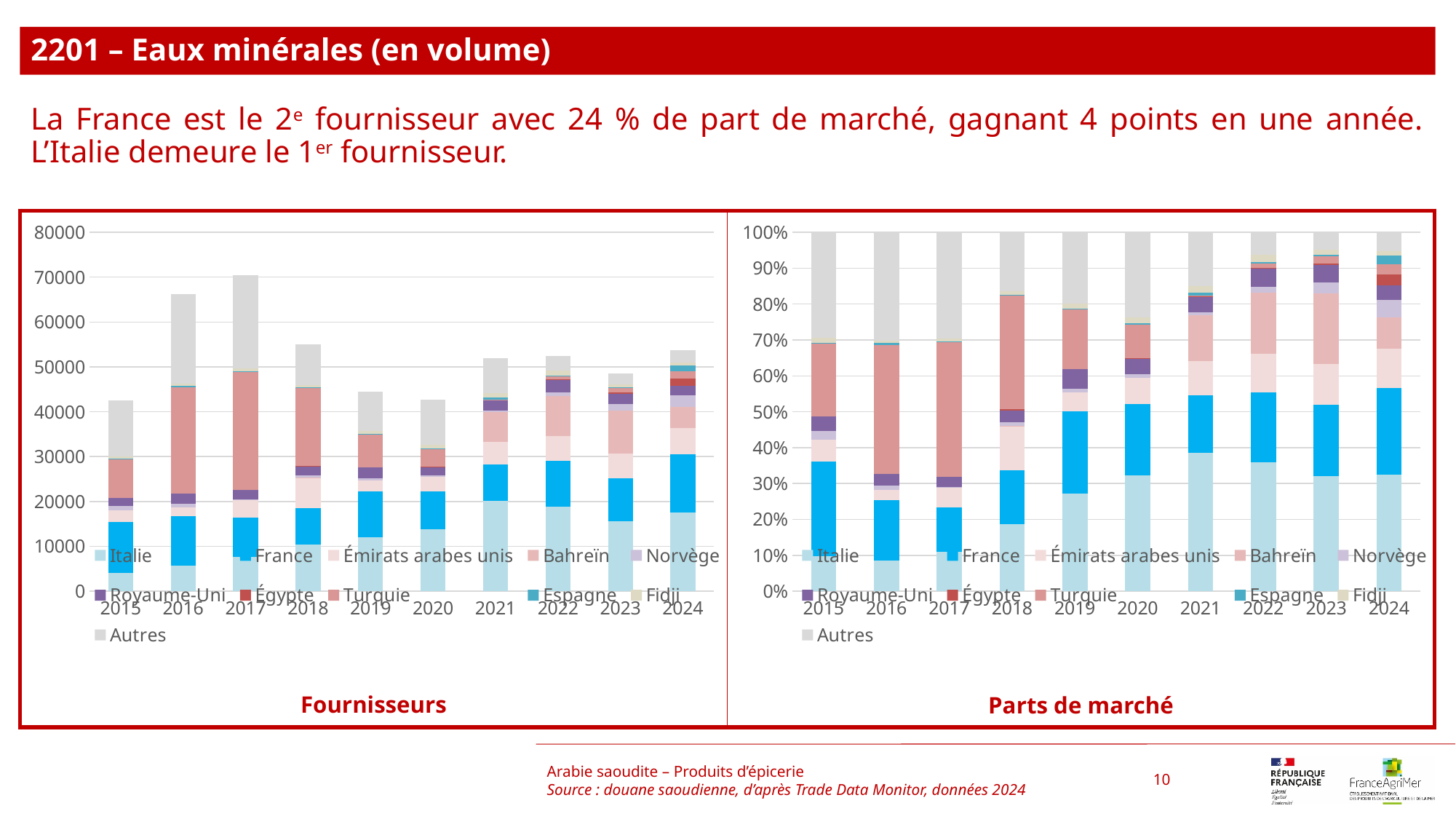
How many years are shown on the x axis of the 'Parts de marché' chart? 10 In the 'Fournisseurs' chart, which year has the tallest total bar? 2017 What is the title of the chart on the right side of the slide? Parts de marché In the 'Fournisseurs' chart, is the total bar for 2017 greater or less than 60000? greater In the 'Parts de marché' chart, does the Italie share rise or fall from 2021 to 2024? fall What kind of chart is the 'Fournisseurs' chart on the left? Stacked bar chart In the 'Fournisseurs' chart, is the total bar for 2019 greater or less than 50000? less In the 'Fournisseurs' chart, is the total bar for 2024 greater or less than 50000? greater How many series does the legend of the 'Fournisseurs' chart list? 11 In the 'Fournisseurs' chart, which total bar is taller, 2016 or 2018? 2016